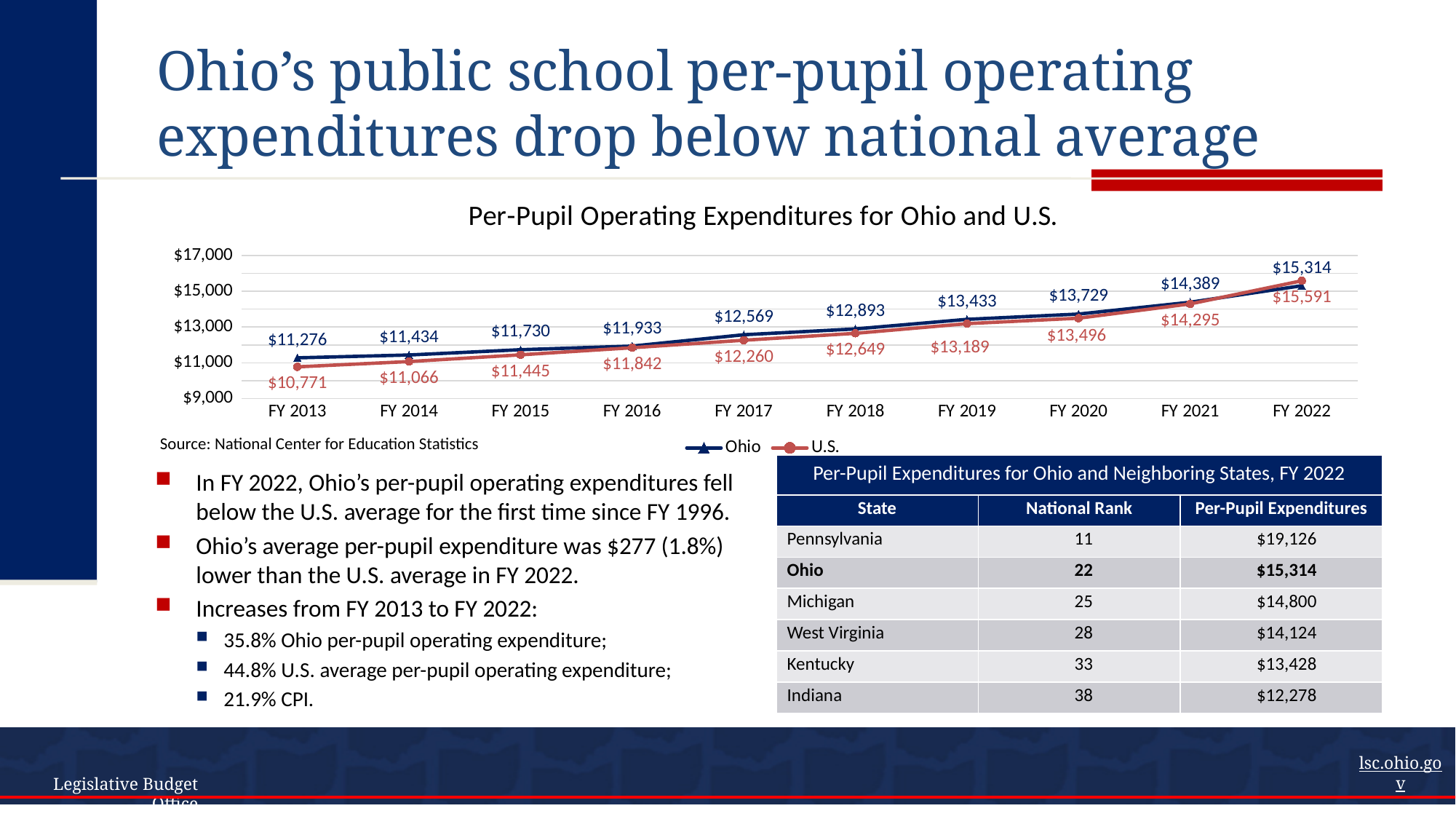
In which fiscal year was the U.S. per-pupil operating expenditure lowest? FY 2013 Do the U.S. per-pupil operating expenditures rise or fall from FY 2013 to FY 2022? rise What type of chart is shown on the slide? line chart In which fiscal year was Ohio's per-pupil operating expenditure highest? FY 2022 What was the U.S. per-pupil operating expenditure in FY 2022? $15,591 What was the U.S. per-pupil operating expenditure in FY 2017? $12,260 In FY 2019, which was larger, Ohio's or the U.S. per-pupil operating expenditure? Ohio How many series does the chart's legend list? 2 What was Ohio's per-pupil operating expenditure in FY 2013? $11,276 How many fiscal years are plotted on the x axis of the chart? 10 What is the difference between Ohio's and the U.S. per-pupil operating expenditure in FY 2022? $277 What is the difference between Ohio's per-pupil operating expenditure in FY 2022 and FY 2013? $4,038